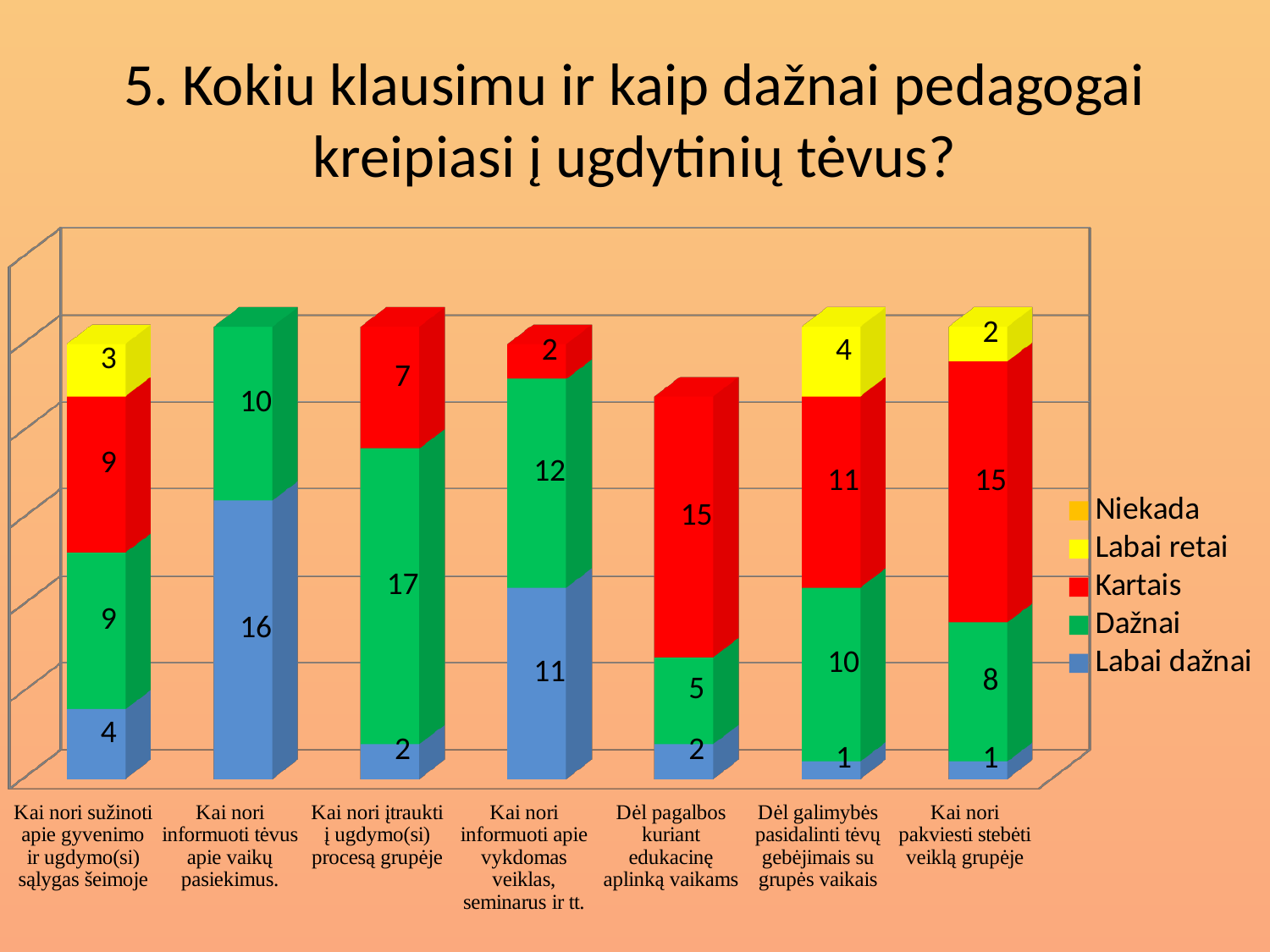
Which legend entry is shown in red? Kartais Which category has the lowest 'Dažnai' value? Dėl pagalbos kuriant edukacinę aplinką vaikams What is the total of the stacked bar for 'Kai nori sužinoti apie gyvenimo ir ugdymo(si) sąlygas šeimoje'? 25 How many series does the legend list? 5 Which is larger: the 'Labai dažnai' value for 'Kai nori informuoti apie vykdomas veiklas, seminarus ir tt.' or the 'Labai dažnai' value for 'Kai nori sužinoti apie gyvenimo ir ugdymo(si) sąlygas šeimoje'? Kai nori informuoti apie vykdomas veiklas, seminarus ir tt. How many categories are shown along the x axis? 7 What kind of chart is shown on the slide? stacked bar chart What is the 'Labai dažnai' value for 'Kai nori informuoti tėvus apie vaikų pasiekimus'? 16 What is the 'Kartais' value for 'Dėl pagalbos kuriant edukacinę aplinką vaikams'? 15 Which category has the highest 'Dažnai' value? Kai nori įtraukti į ugdymo(si) procesą grupėje What is the difference between the 'Dažnai' value for 'Kai nori įtraukti į ugdymo(si) procesą grupėje' and the 'Dažnai' value for 'Kai nori pakviesti stebėti veiklą grupėje'? 9 What is the 'Labai retai' value for 'Dėl galimybės pasidalinti tėvų gebėjimais su grupės vaikais'? 4